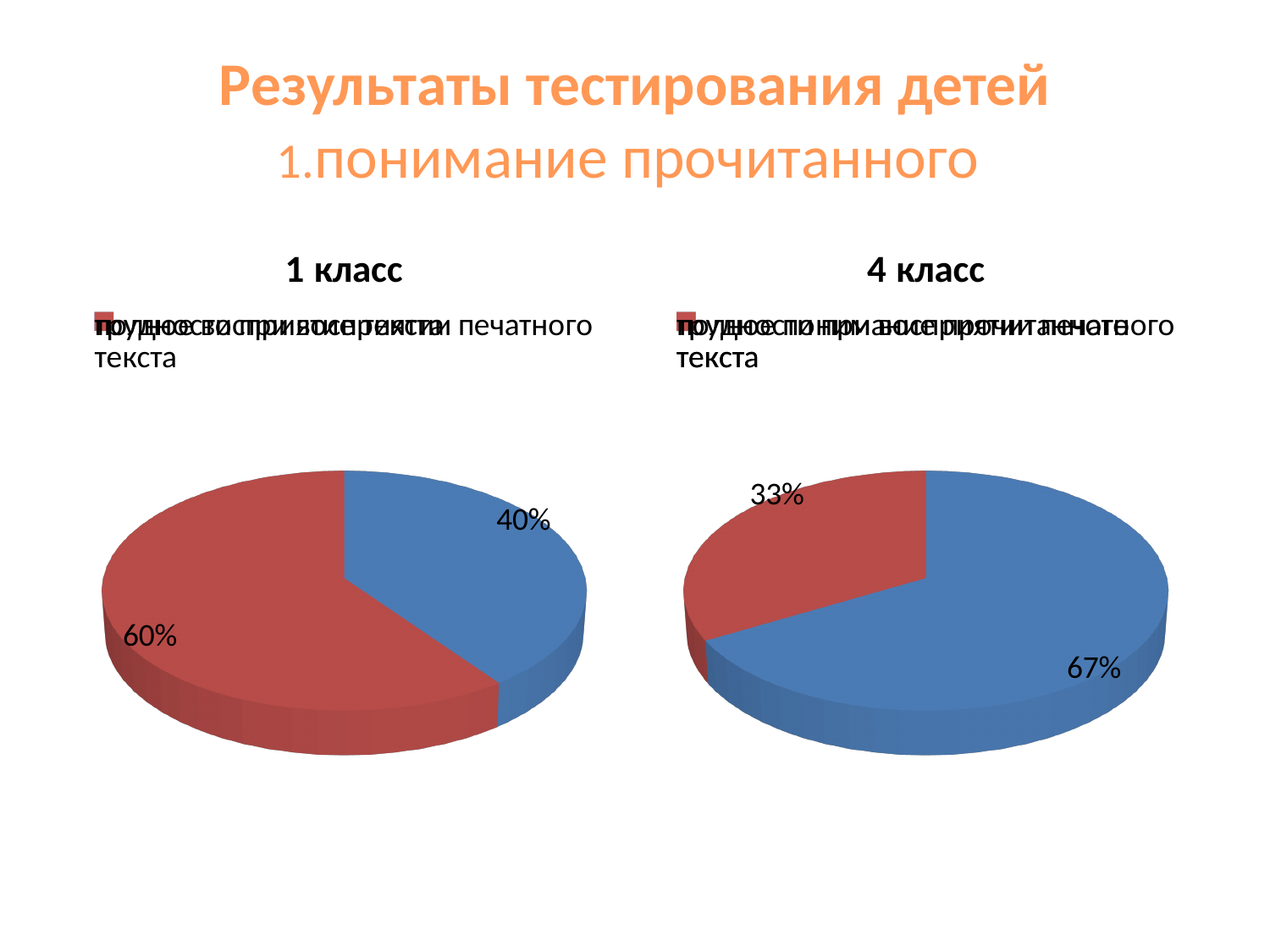
How many slices does the "4 класс" pie chart have? 2 What is the title of the chart on the left side of the slide? 1 класс In the "4 класс" chart, what is the difference between the blue slice and the red slice? 34% In the "4 класс" chart, what percentage is shown for the blue slice? 67% In the "1 класс" chart, what is the difference between the red slice and the blue slice? 20% In the "1 класс" chart, what percentage is shown for the red slice? 60% What kind of chart is the "1 класс" chart? pie chart In the "1 класс" chart, which slice is larger, the red one or the blue one? red In the "4 класс" chart, what percentage is shown for the red slice? 33% In the "1 класс" chart, what percentage is shown for the blue slice? 40% In the "4 класс" chart, which slice is the largest? blue What kind of chart is the "4 класс" chart? pie chart